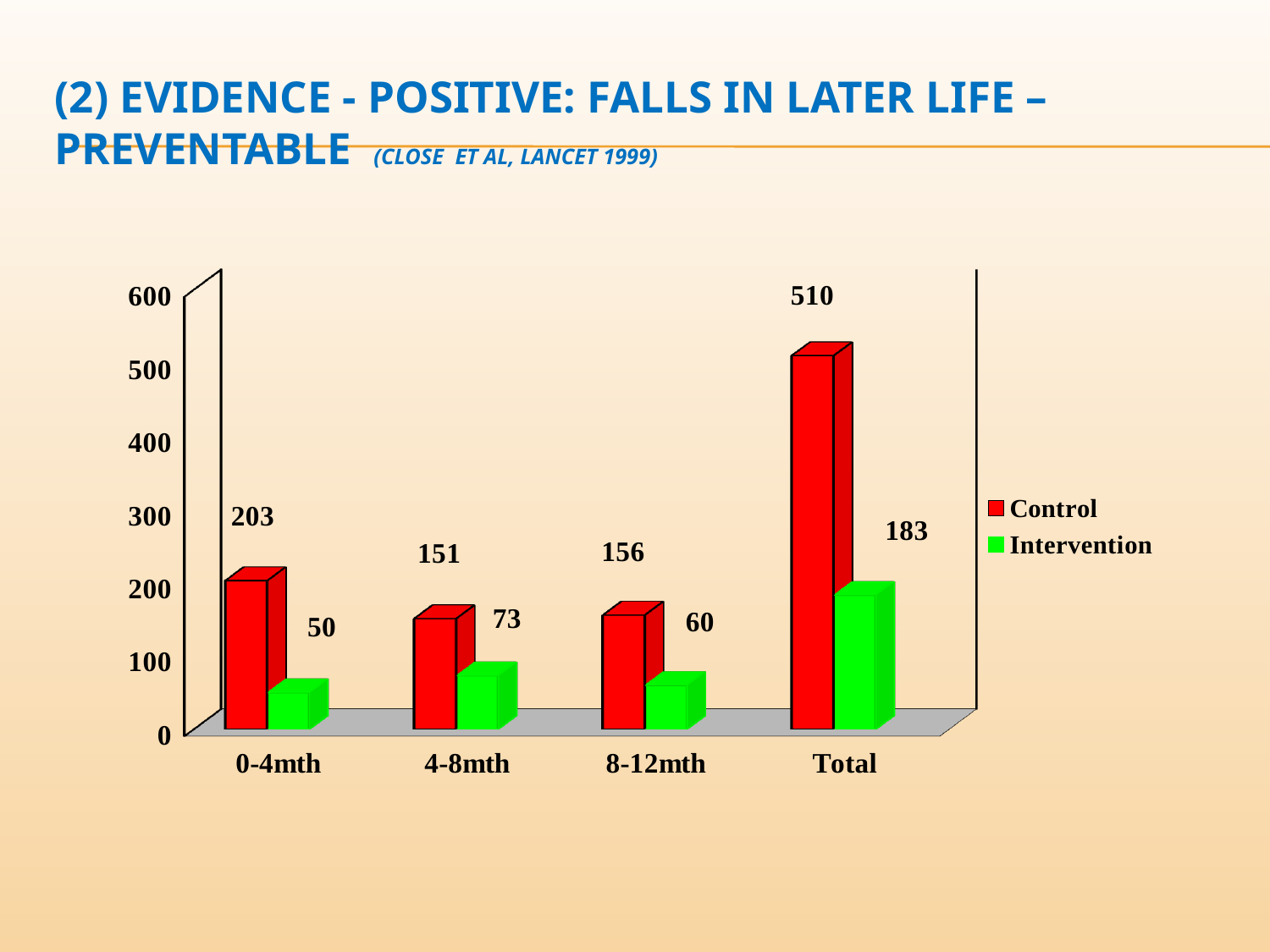
How many categories are shown on the x axis? 4 How many series does the legend list? 2 What is the Intervention value for Total? 183 Which category has the highest Control value? Total What is the difference between the Control and Intervention values for 8-12mth? 96 Which category has the lowest Intervention value? 0-4mth Which colour represents the Intervention series? green Is the Control value for Total greater or less than 500? greater Which is larger, the Control value for 4-8mth or the Control value for 8-12mth? 8-12mth What kind of chart is shown on the slide? bar chart What is the Control value for 0-4mth? 203 What is the Intervention value for 4-8mth? 73